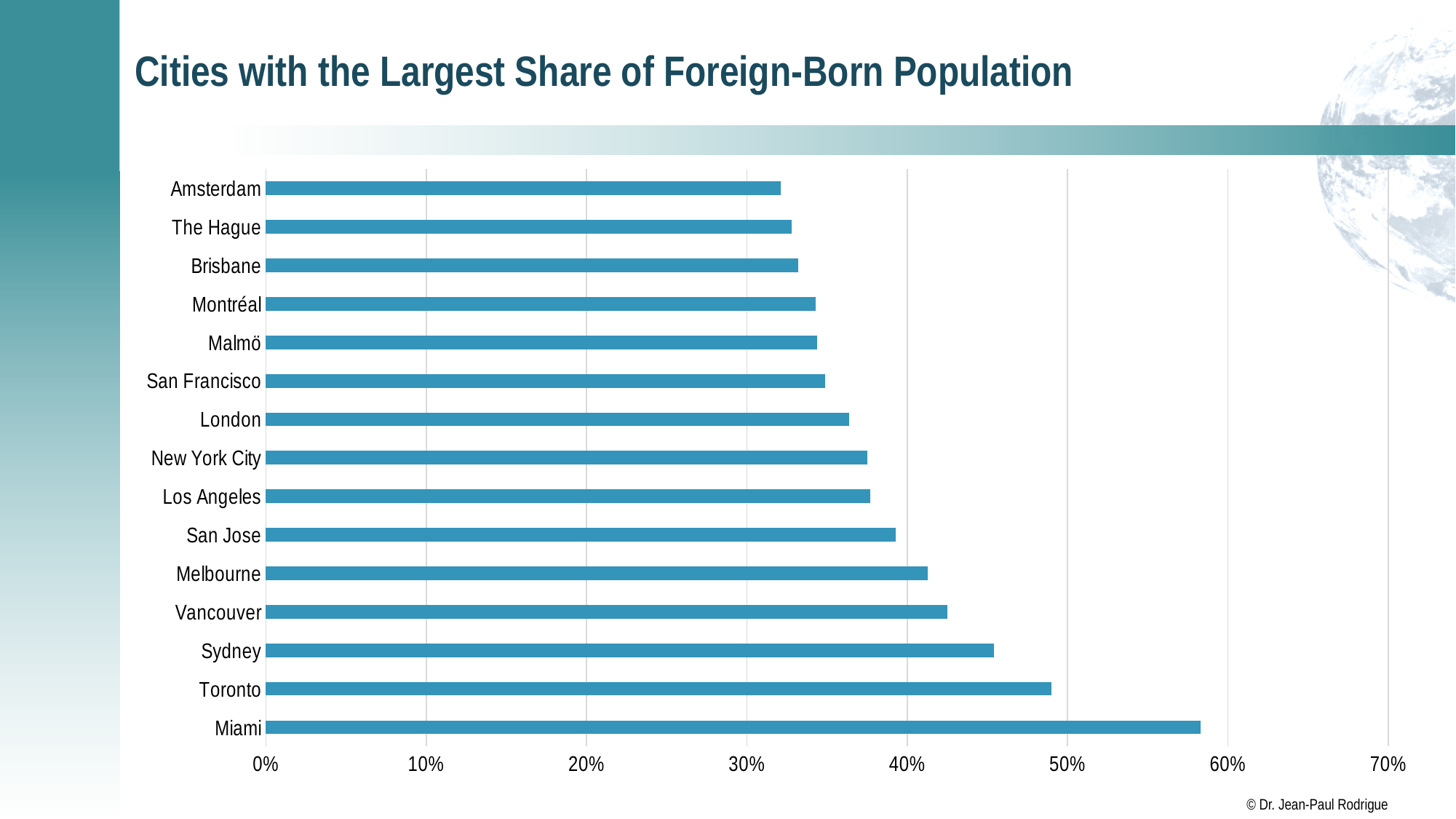
What kind of chart is shown on the slide? bar chart Is the value for Sydney greater or less than 40%? greater Is the value for Amsterdam greater or less than 30%? greater What is the title of the chart? Cities with the Largest Share of Foreign-Born Population Which city has the largest share of foreign-born population in the chart? Miami What is the highest value shown on the horizontal axis? 70% Is the value for Vancouver greater or less than 40%? greater Which has a larger share of foreign-born population, London or Vancouver? Vancouver Which has a larger share of foreign-born population, Toronto or Sydney? Toronto How many cities are plotted in the chart? 15